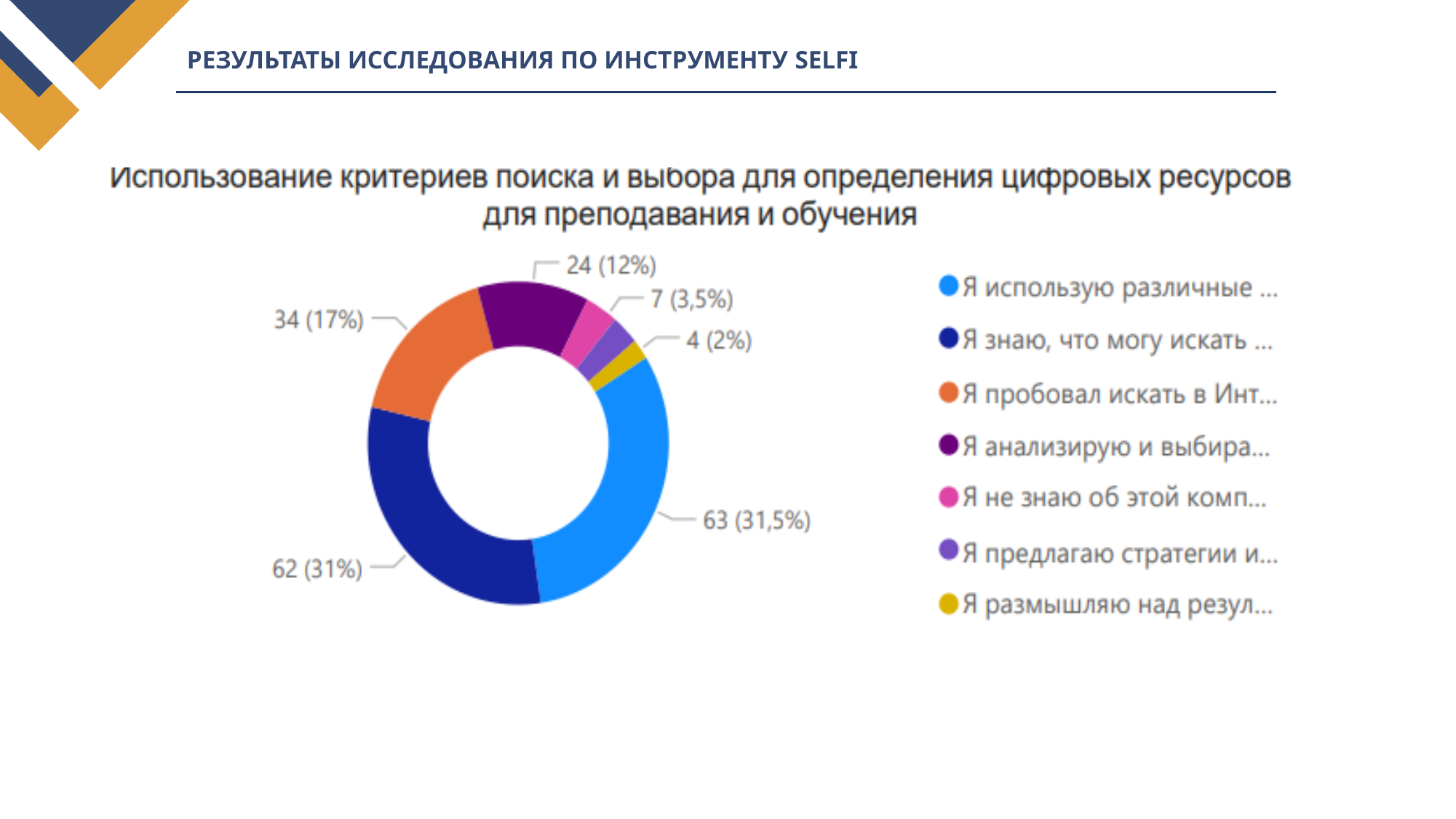
Which category has the highest value in the chart? Я использую различные ... Which is larger: the value for "Я анализирую и выбира..." or the value for "Я не знаю об этой комп..."? Я анализирую и выбира... What is the value shown for the category "Я знаю, что могу искать ..."? 62 (31%) What type of chart is shown on the slide? Donut (pie) chart What is the value shown for the category "Я пробовал искать в Инт..."? 34 (17%) What is the difference between the values for "Я пробовал искать в Инт..." and "Я анализирую и выбира..."? 10 How many categories does the legend of the chart list? 7 What is the value shown for the category "Я анализирую и выбира..."? 24 (12%) What colour is the slice for "Я пробовал искать в Инт..."? Orange What share of the chart does the category "Я не знаю об этой комп..." represent? 3,5% What is the value shown for the category "Я использую различные ..."? 63 (31,5%)